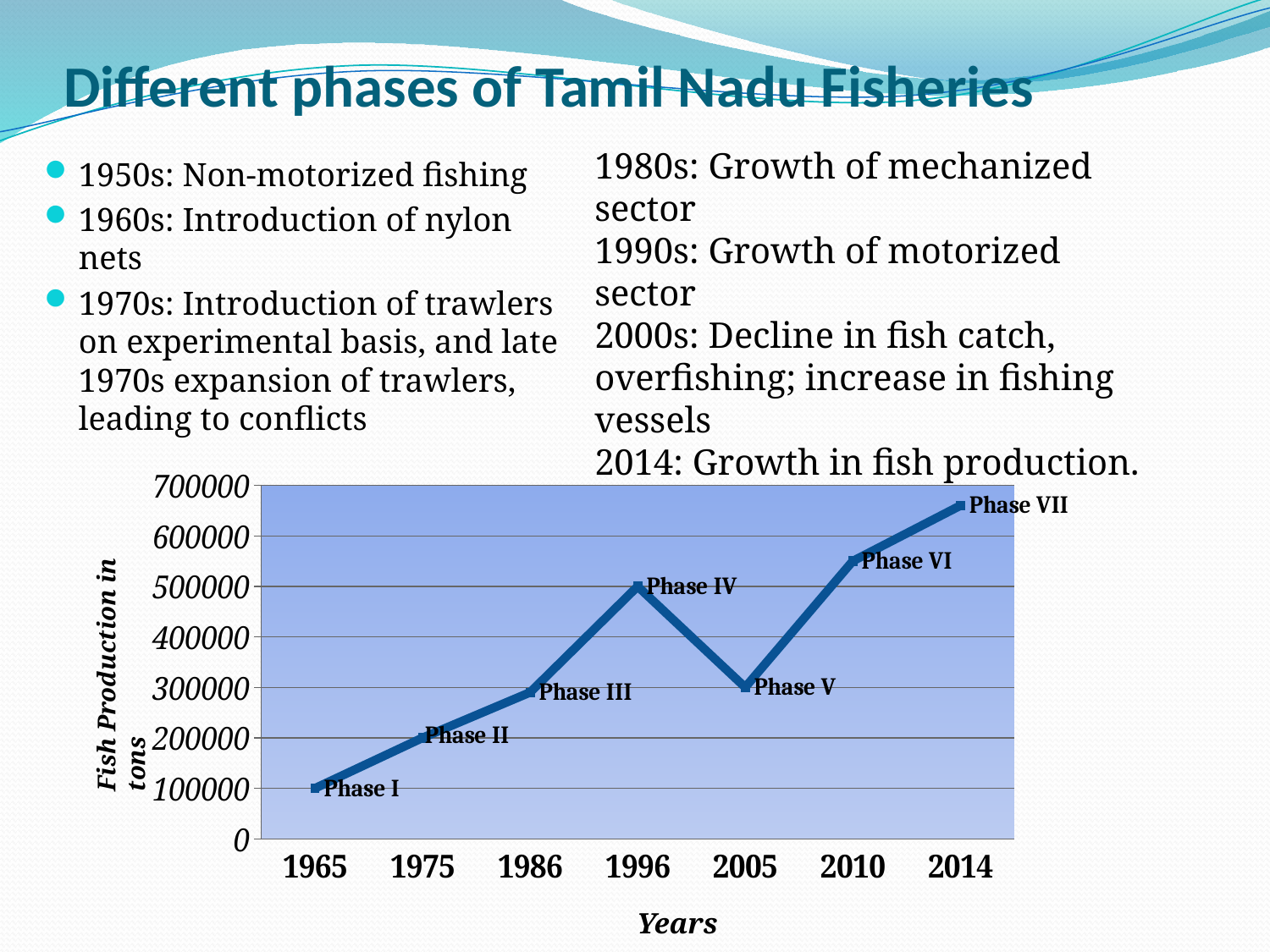
Which year has the lowest fish production on the chart? 1965 What is the title of the x axis of the chart? Years Is the fish production value for 2010 greater or less than 500000? greater Which year has the highest fish production on the chart? 2014 What is the difference in fish production between 1996 and 1965? 400000 What kind of chart is shown on the slide? line chart Which year has higher fish production, 1996 or 2005? 1996 How many data points (years) are plotted on the chart? 7 What is the fish production value for 1965? 100000 Does fish production rise or fall between 1996 and 2005? fall What is the fish production value for 1996? 500000 Is the fish production value for 2014 greater or less than 600000? greater